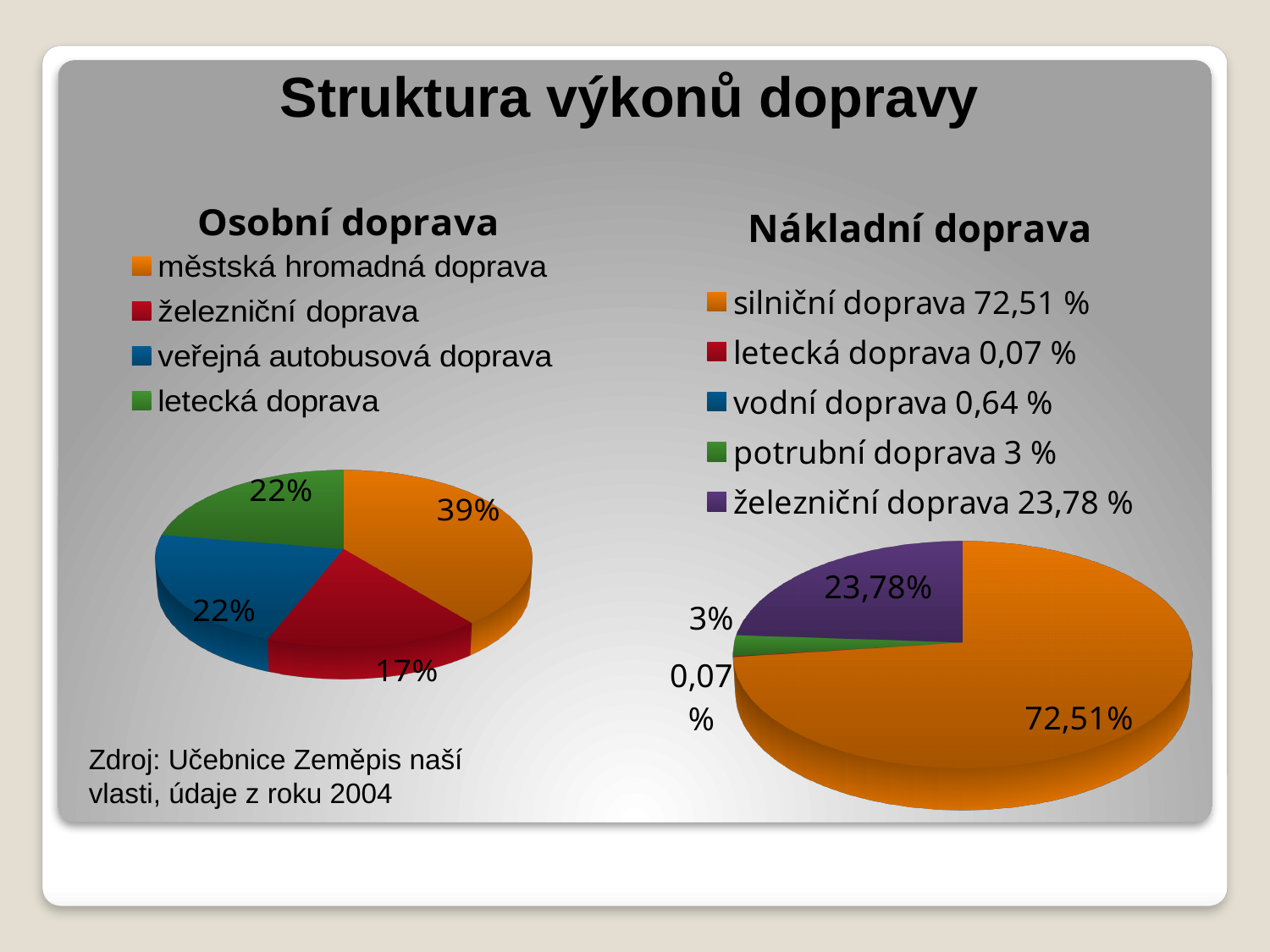
How many categories does the 'Osobní doprava' chart show? 4 In the 'Osobní doprava' chart, which category has the smallest share? železniční doprava In the 'Nákladní doprava' chart, what share does silniční doprava have? 72,51% In the 'Nákladní doprava' chart, which category has the smallest share? letecká doprava In the 'Nákladní doprava' chart, which is larger: potrubní doprava or vodní doprava? potrubní doprava In the 'Osobní doprava' chart, which category has the largest share? městská hromadná doprava In the 'Nákladní doprava' chart, what share does železniční doprava have? 23,78% In the 'Osobní doprava' chart, what is the difference between the shares of městská hromadná doprava and železniční doprava? 22% What type of chart is the 'Nákladní doprava' chart? pie chart How many categories does the legend of the 'Nákladní doprava' chart list? 5 In the 'Osobní doprava' chart, what share does železniční doprava have? 17% In the 'Osobní doprava' chart, what share does městská hromadná doprava have? 39%